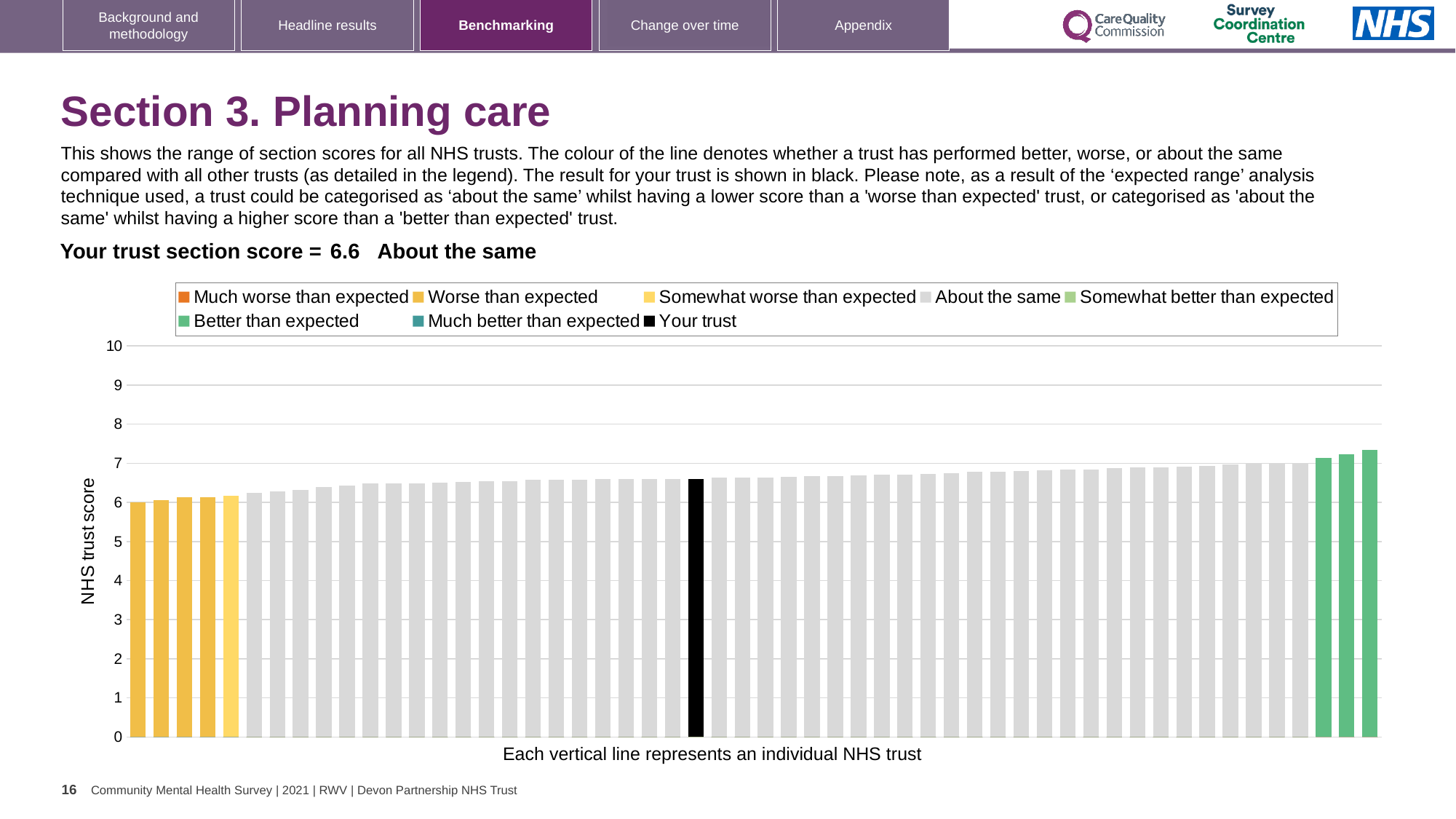
Is the shortest bar in the chart greater or less than 5? greater What kind of chart is shown on the slide? bar chart How many bars are coloured as 'Better than expected' (green)? 3 Is the value for your trust (the black bar) greater or less than 5? greater Is the value for your trust (the black bar) greater or less than 7? less What is the label on the vertical axis of the chart? NHS trust score Do the bar values rise or fall from left to right across the chart? rise How many bars are coloured as 'Much worse than expected' (orange)? 0 How many bars are coloured as 'Worse than expected' (dark yellow)? 4 What is the section score for your trust shown on the slide? 6.6 How many entries does the chart legend list? 8